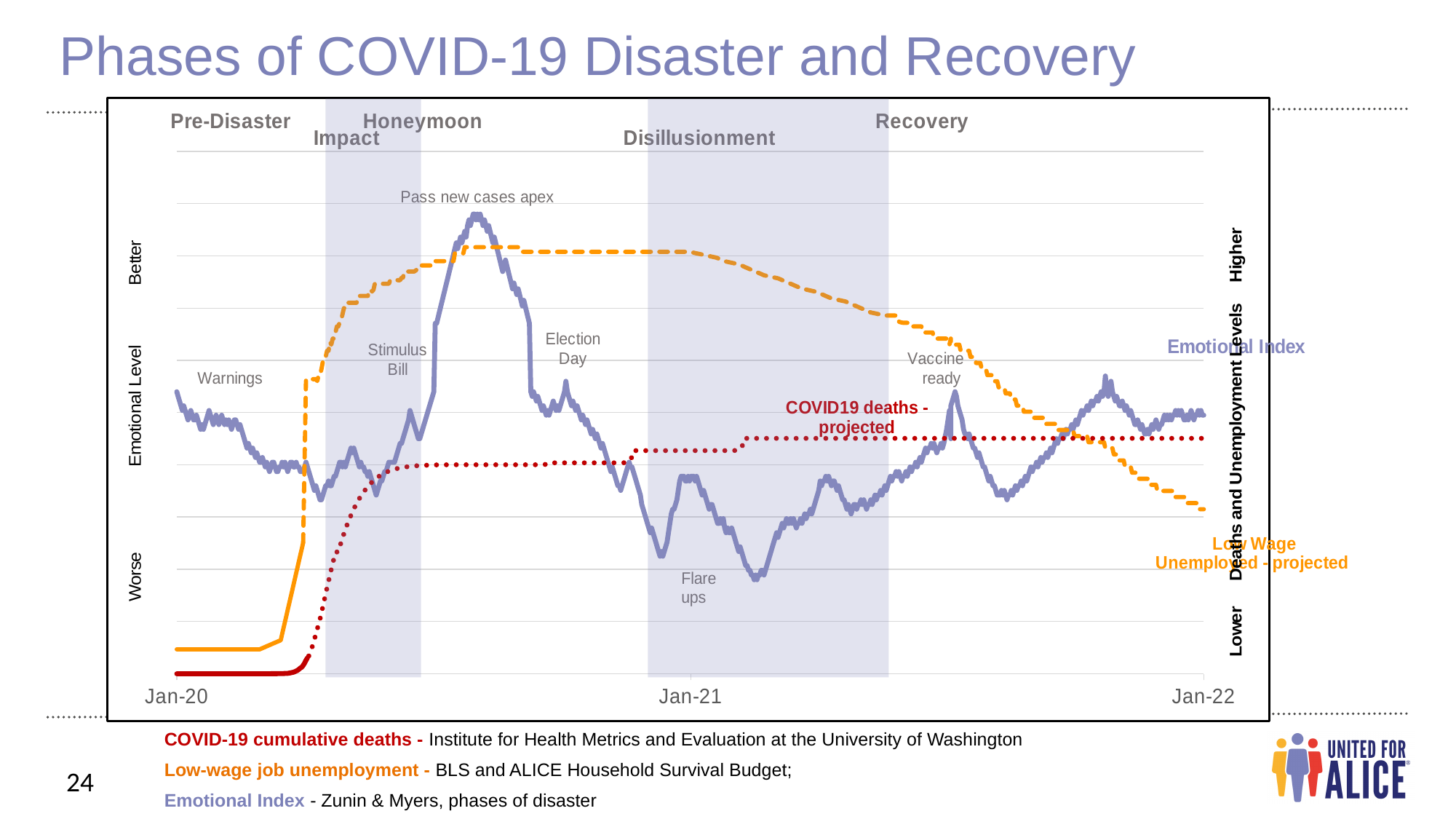
Which series is drawn in orange dashed line? Low Wage Unemployed - projected What is the title of the slide's chart? Phases of COVID-19 Disaster and Recovery Which annotated event marks the highest point of the Emotional Index line? Pass new cases apex How many dates are labelled on the x axis? 3 How many disaster phases are labelled across the top of the chart? 5 Does the Low Wage Unemployed - projected line rise or fall during the Recovery phase? fall What is the first date labelled on the x axis? Jan-20 What is the last date labelled on the x axis? Jan-22 Does the COVID19 deaths - projected line rise or fall between Jan-20 and Jan-21? rise What kind of chart is shown on the slide? line chart In which phase does the Emotional Index line reach its lowest point? Disillusionment